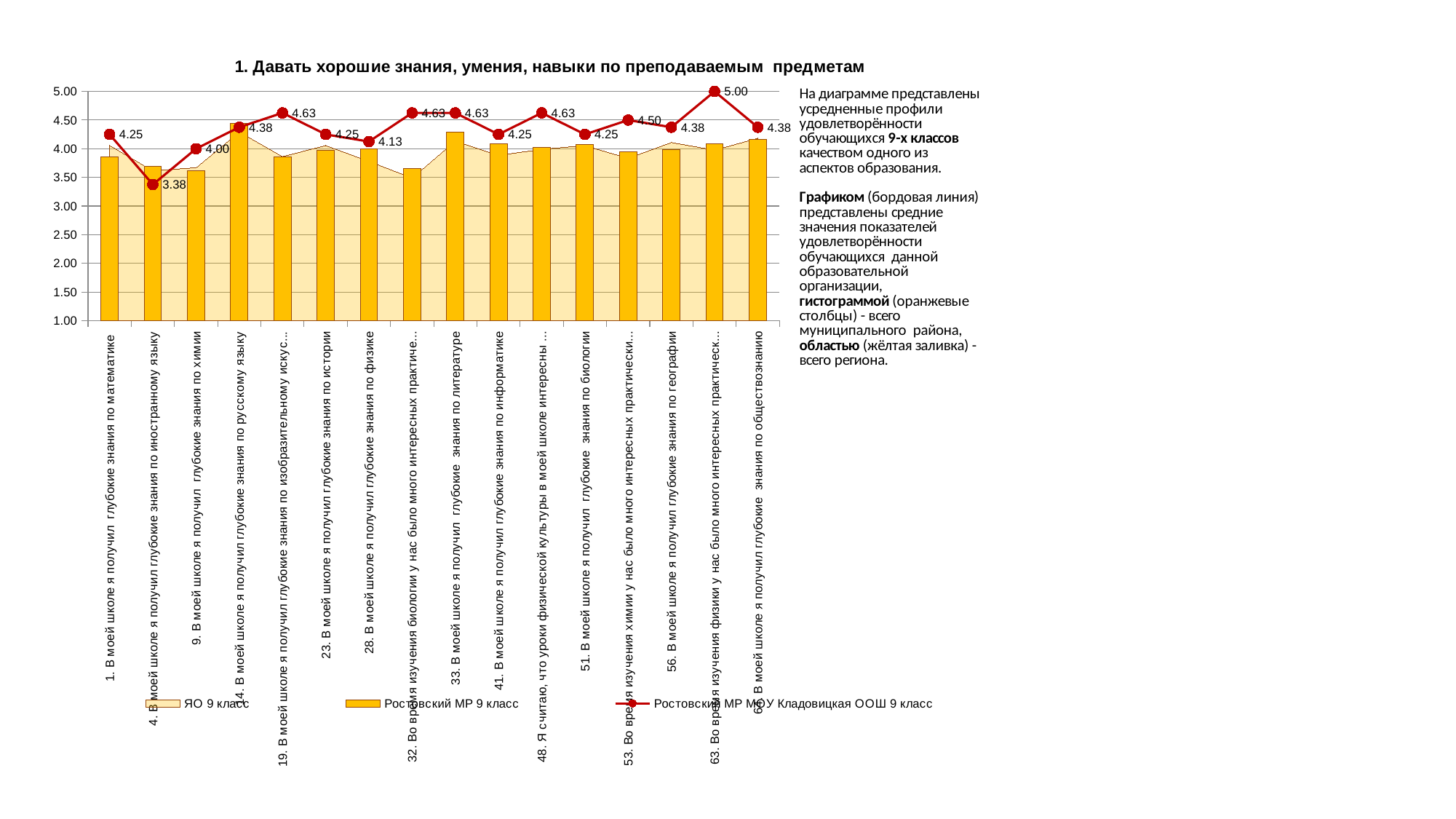
What is the difference between the highest and lowest values on the Ростовский МР МОУ Кладовицкая ООШ 9 класс line? 1.62 On the Ростовский МР МОУ Кладовицкая ООШ 9 класс line, which is larger: the value for '14. ...по русскому языку' or for '23. ...по истории'? 14. ...по русскому языку Is the Ростовский МР 9 класс bar for '1. В моей школе я получил глубокие знания по математике' greater or less than 3.50? greater Which category has the highest value on the Ростовский МР МОУ Кладовицкая ООШ 9 класс line? 63. Во время изучения физики у нас было много интересных практическ... (5.00) What is the title of the chart? 1. Давать хорошие знания, умения, навыки по преподаваемым предметам How many series does the chart legend list? 3 What is the value of the Ростовский МР МОУ Кладовицкая ООШ 9 класс line for '4. В моей школе я получил глубокие знания по иностранному языку'? 3.38 On the Ростовский МР МОУ Кладовицкая ООШ 9 класс line, how much higher is the value for '19. ...изобразительному искус...' than for '28. ...по физике'? 0.50 Which category has the lowest value on the Ростовский МР МОУ Кладовицкая ООШ 9 класс line? 4. В моей школе я получил глубокие знания по иностранному языку (3.38) What is the value of the Ростовский МР МОУ Кладовицкая ООШ 9 класс line for '1. В моей школе я получил глубокие знания по математике'? 4.25 How many categories are shown on the x axis of the chart? 16